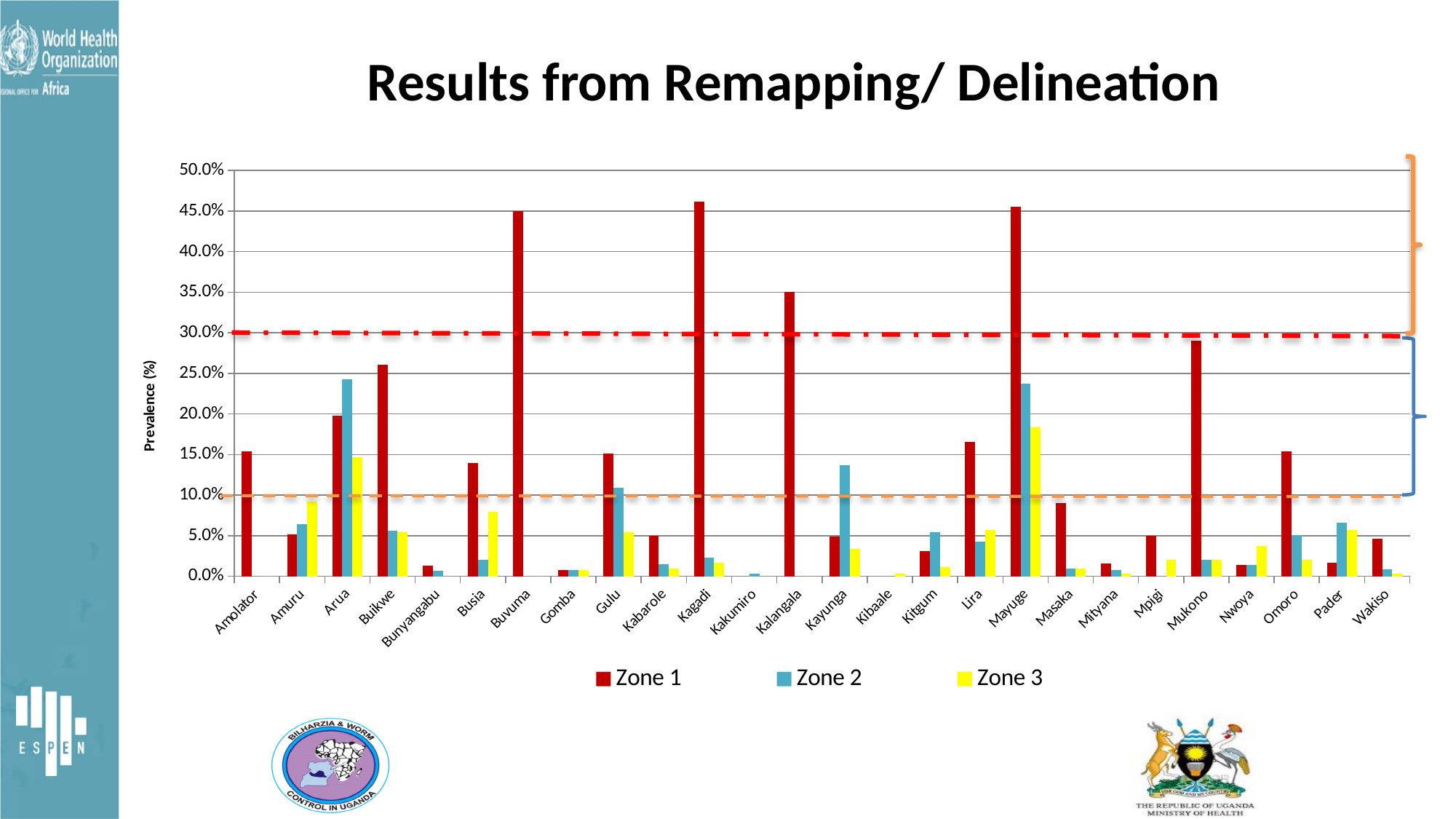
Is the Zone 1 value for Buvuma greater or less than 40.0%? greater What kind of chart is shown on the slide? bar chart Is the Zone 1 value for Kalangala greater or less than 30.0%? greater How many series does the legend list? 3 For Kayunga, which is larger: the Zone 1 value or the Zone 2 value? Zone 2 Which district has the highest Zone 3 value? Mayuge Is the Zone 2 value for Arua greater or less than 20.0%? greater What is the label of the y axis? Prevalence (%) How many districts (categories) are shown on the x axis? 26 For Arua, which is larger: the Zone 1 value or the Zone 2 value? Zone 2